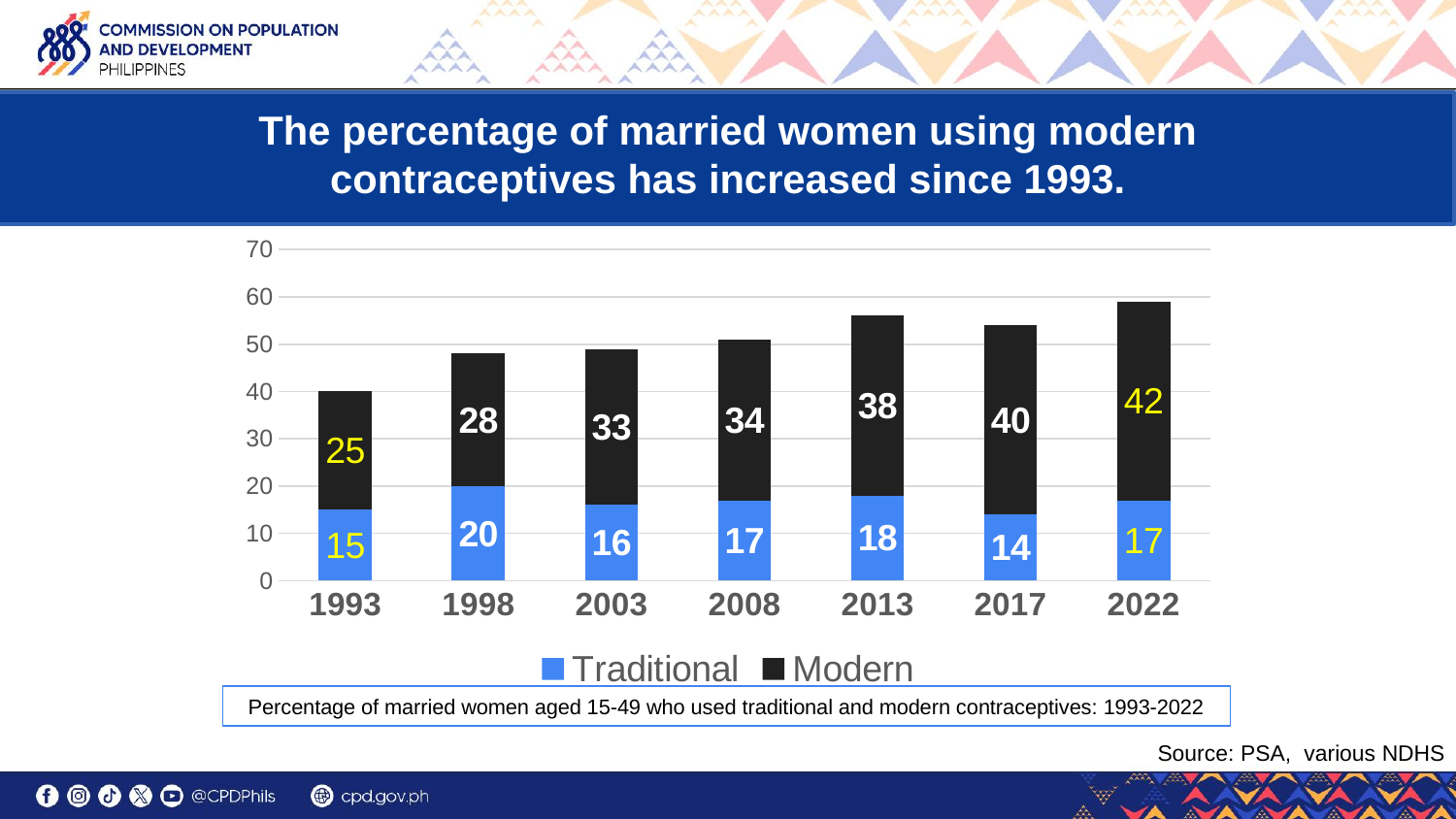
How many years are shown on the x axis? 7 Which year has the lowest Traditional value? 2017 What is the Traditional value for 1998? 20 Does the Modern value rise or fall from 1993 to 2022? Rise What kind of chart is shown? Stacked bar chart Which is larger, the Traditional value for 2013 or the Traditional value for 2017? 2013 What is the Modern value for 2013? 38 How many series does the legend list? 2 What is the total of the stacked bar for 2022? 59 Which year has the highest Modern value? 2022 What is the Modern value for 1993? 25 What is the difference between the Modern values for 2022 and 1993? 17